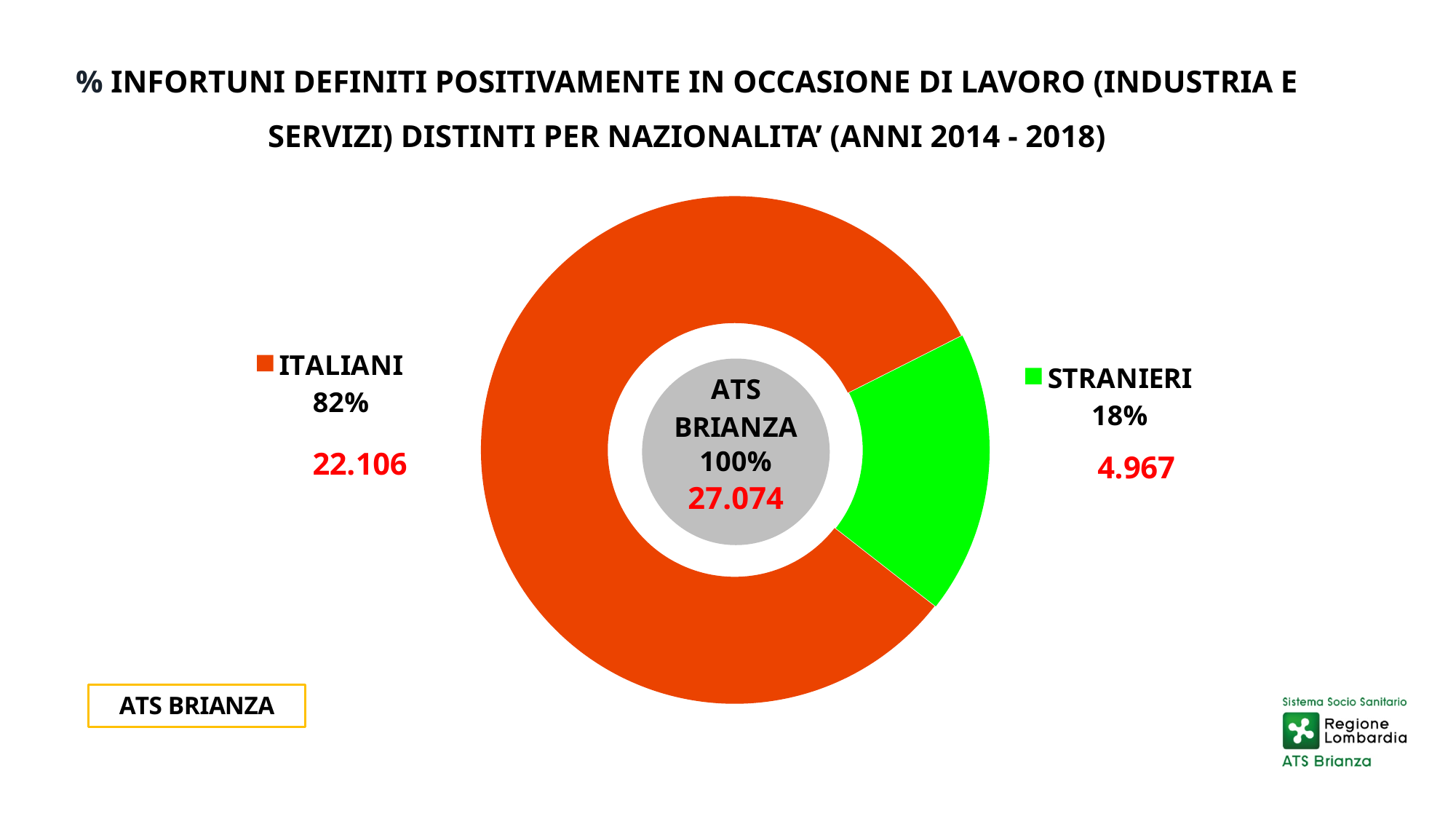
What is the count shown for ITALIANI? 22.106 What total is shown in the centre of the chart for ATS BRIANZA? 27.074 Which is larger, the count for ITALIANI or the count for STRANIERI? ITALIANI What percentage share does the STRANIERI slice have? 18% What kind of chart is shown on the slide? Pie chart (doughnut) What is the difference in percentage points between the ITALIANI and STRANIERI shares? 64 Which category has the smallest slice? STRANIERI What percentage share does the ITALIANI slice have? 82% What colour is the STRANIERI slice? Green Which category has the largest slice? ITALIANI How many categories does the chart show? 2 What is the count shown for STRANIERI? 4.967